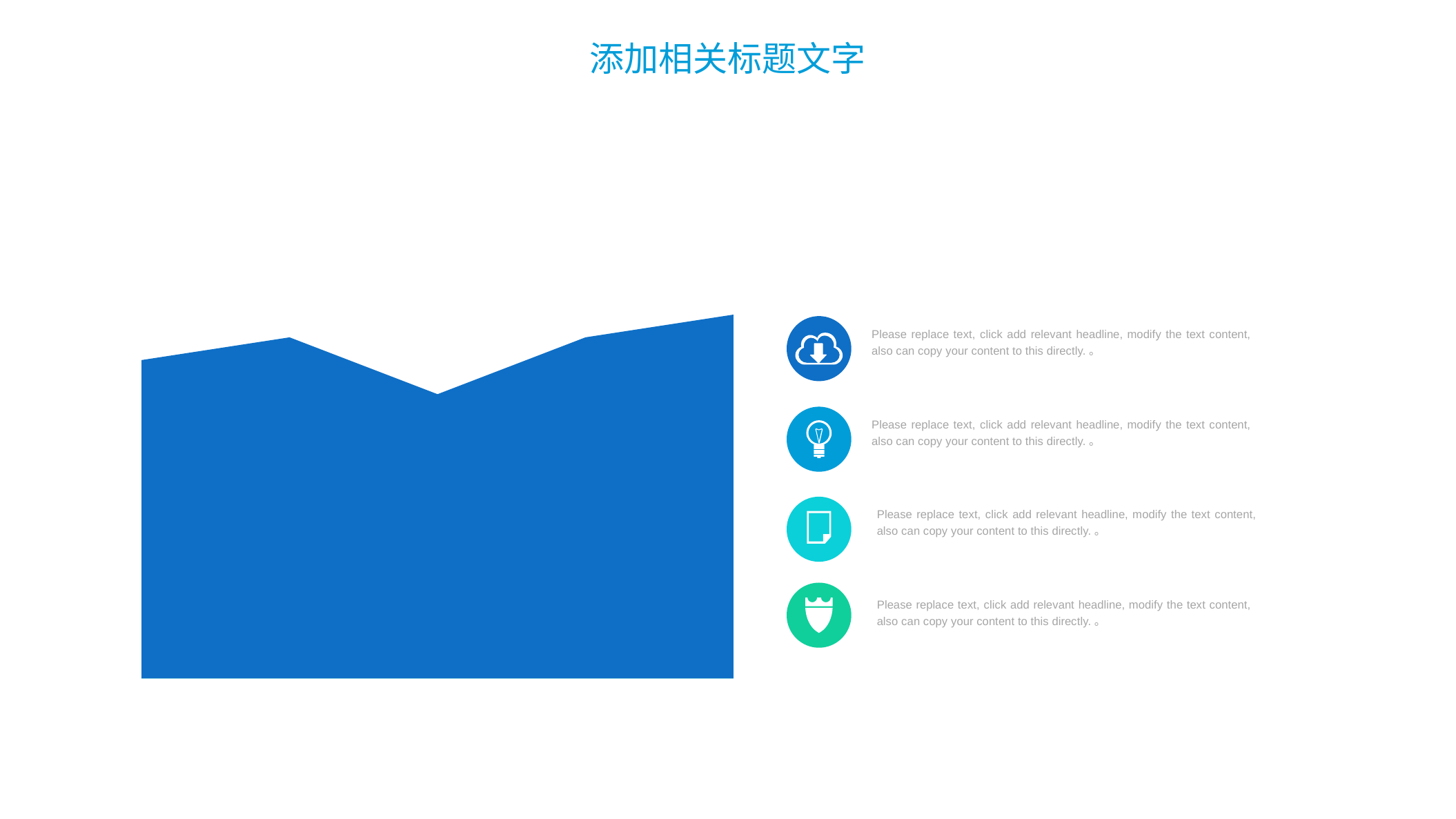
How many data points does the area chart on the left have? 5 In the area chart on the left, which point is the lowest: the first, the middle, or the last? the middle In the area chart on the left, do the values rise or fall from the middle point to the rightmost point? rise In the area chart on the left, is the first point or the last point higher? the last point Does the area chart on the left show a legend? no What colour is the filled area in the chart on the left? blue What kind of chart is shown on the left of the slide? area chart In the area chart on the left, do the values rise or fall from the second point to the middle point? fall In the area chart on the left, which point is the highest: the first, the middle, or the last? the last